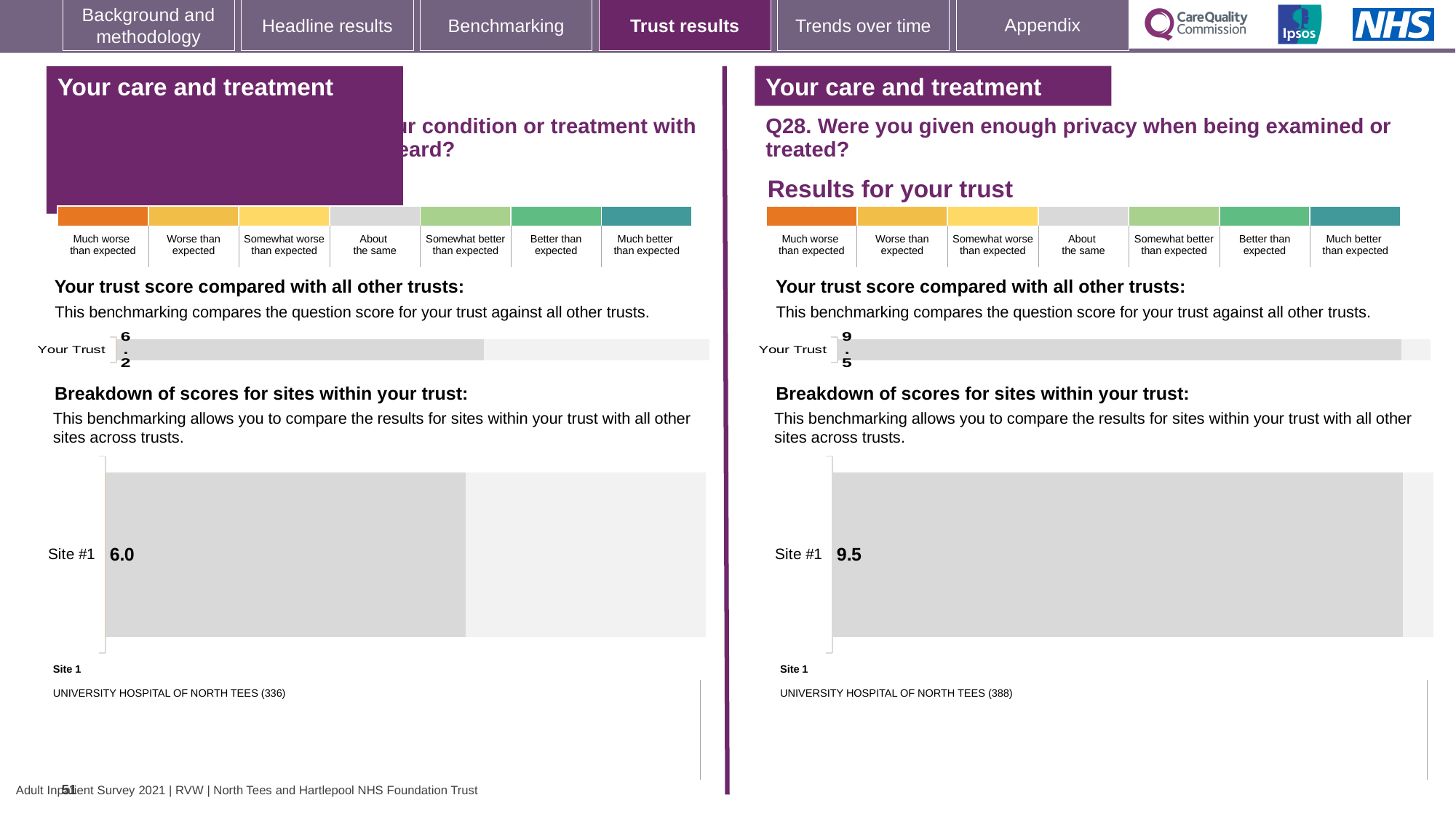
What is the difference between the Your Trust score on the right-hand side (Q28) and the Your Trust score on the left-hand side of the slide? 3.3 On the right-hand side of the slide (Q28), what score is shown for Site #1 in the 'Breakdown of scores for sites within your trust' chart? 9.5 Which is larger: the Site #1 score on the left-hand side of the slide or the Site #1 score on the right-hand side (Q28)? Right-hand side (Q28), 9.5 On the left-hand side of the slide, what score is shown for Site #1 in the 'Breakdown of scores for sites within your trust' chart? 6.0 How many sites are plotted in the 'Breakdown of scores for sites within your trust' chart on the right-hand side of the slide (Q28)? 1 How many sites are plotted in the 'Breakdown of scores for sites within your trust' chart on the left-hand side of the slide? 1 On the left-hand side of the slide, what is the difference between the Your Trust score and the Site #1 score? 0.2 On the left-hand side of the slide, what is the score shown for Your Trust in the 'Your trust score compared with all other trusts' chart? 6.2 Which site is listed as Site 1 beneath the breakdown chart on the right-hand side of the slide (Q28)? UNIVERSITY HOSPITAL OF NORTH TEES (388) What kind of chart is used to show the Site #1 score on the right-hand side of the slide (Q28)? bar chart What is the difference between the Site #1 score on the right-hand side (Q28) and the Site #1 score on the left-hand side of the slide? 3.5 On the right-hand side of the slide (Q28), what is the score shown for Your Trust in the 'Your trust score compared with all other trusts' chart? 9.5